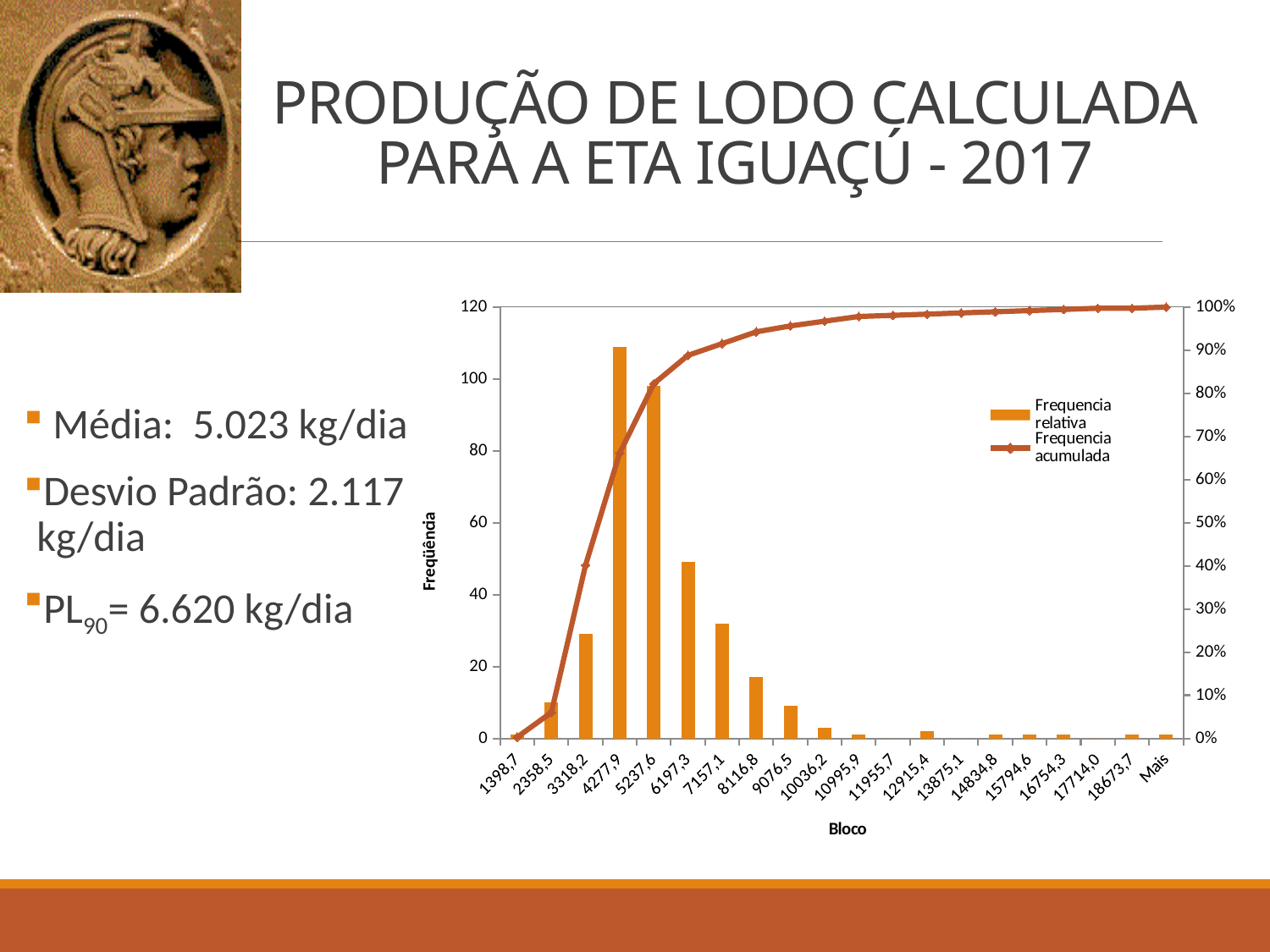
Is the Frequencia relativa value for bloco 4277,9 greater or less than 100? greater Is the Frequencia relativa value for bloco 6197,3 greater or less than 60? less Is the Frequencia relativa value for bloco 5237,6 greater or less than 80? greater How many series does the chart legend list? 2 Which bloco has the larger Frequencia relativa bar, 6197,3 or 7157,1? 6197,3 Which bloco has the highest Frequencia relativa bar? 4277,9 Does the Frequencia acumulada line rise or fall along the x axis? rise What is the title of the x axis of the chart? Bloco How many categories (blocos) are shown on the x axis of the chart? 20 Which bloco has the larger Frequencia relativa bar, 4277,9 or 5237,6? 4277,9 What kind of chart is shown on the slide? A bar chart combined with a line